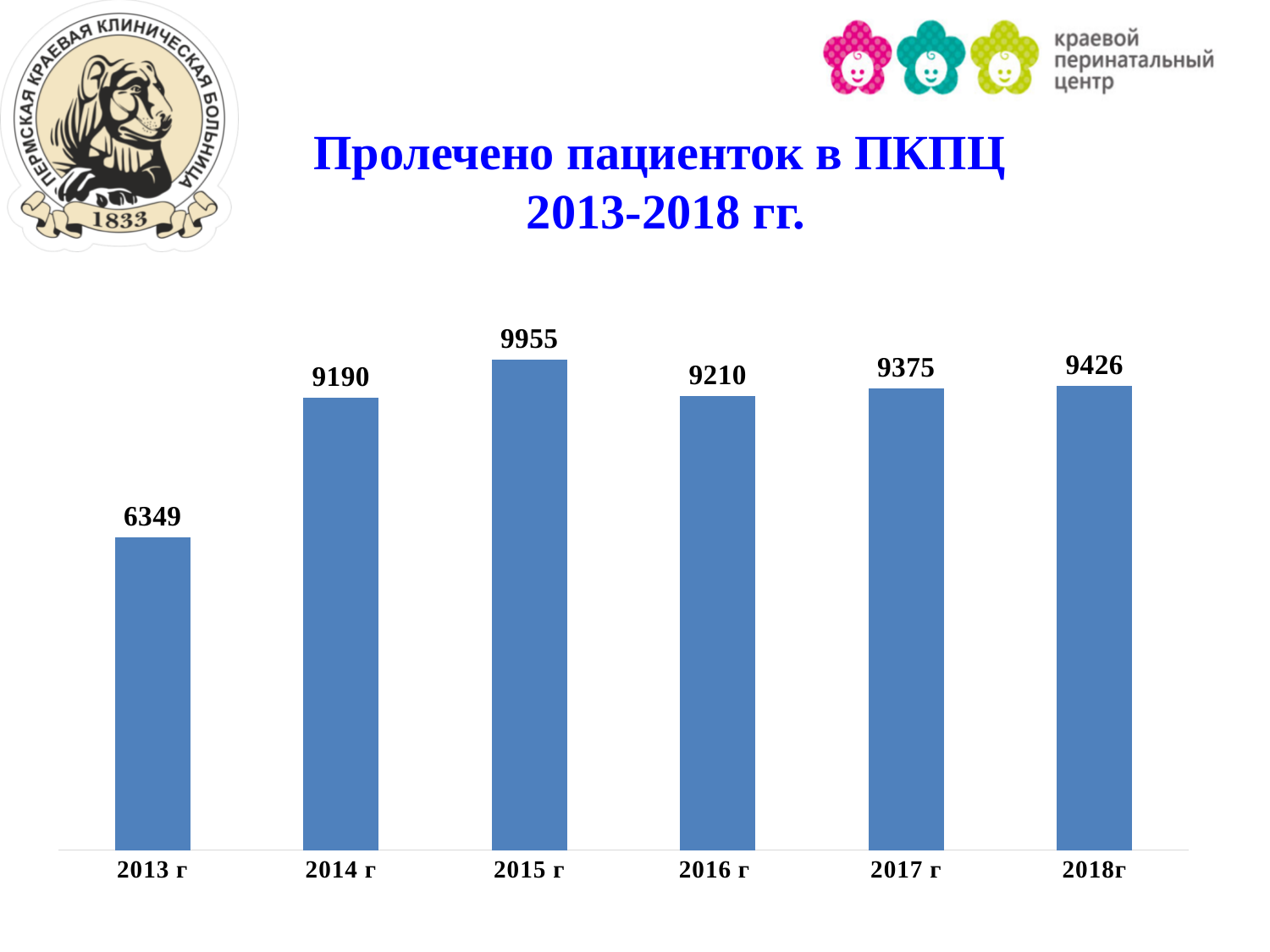
Which is larger, the value for 2014 г or the value for 2016 г? 2016 г Which year has the highest value? 2015 г What is the difference between the values for 2018г and 2017 г? 51 What kind of chart is shown on the slide? bar chart How many years are shown on the chart? 6 Which year has the lowest value? 2013 г What is the value for 2017 г? 9375 What is the title of the chart? Пролечено пациенток в ПКПЦ 2013-2018 гг. What is the difference between the values for 2015 г and 2013 г? 3606 Do the values rise or fall from 2013 г to 2014 г? rise What is the value for 2013 г? 6349 What is the value for 2015 г? 9955